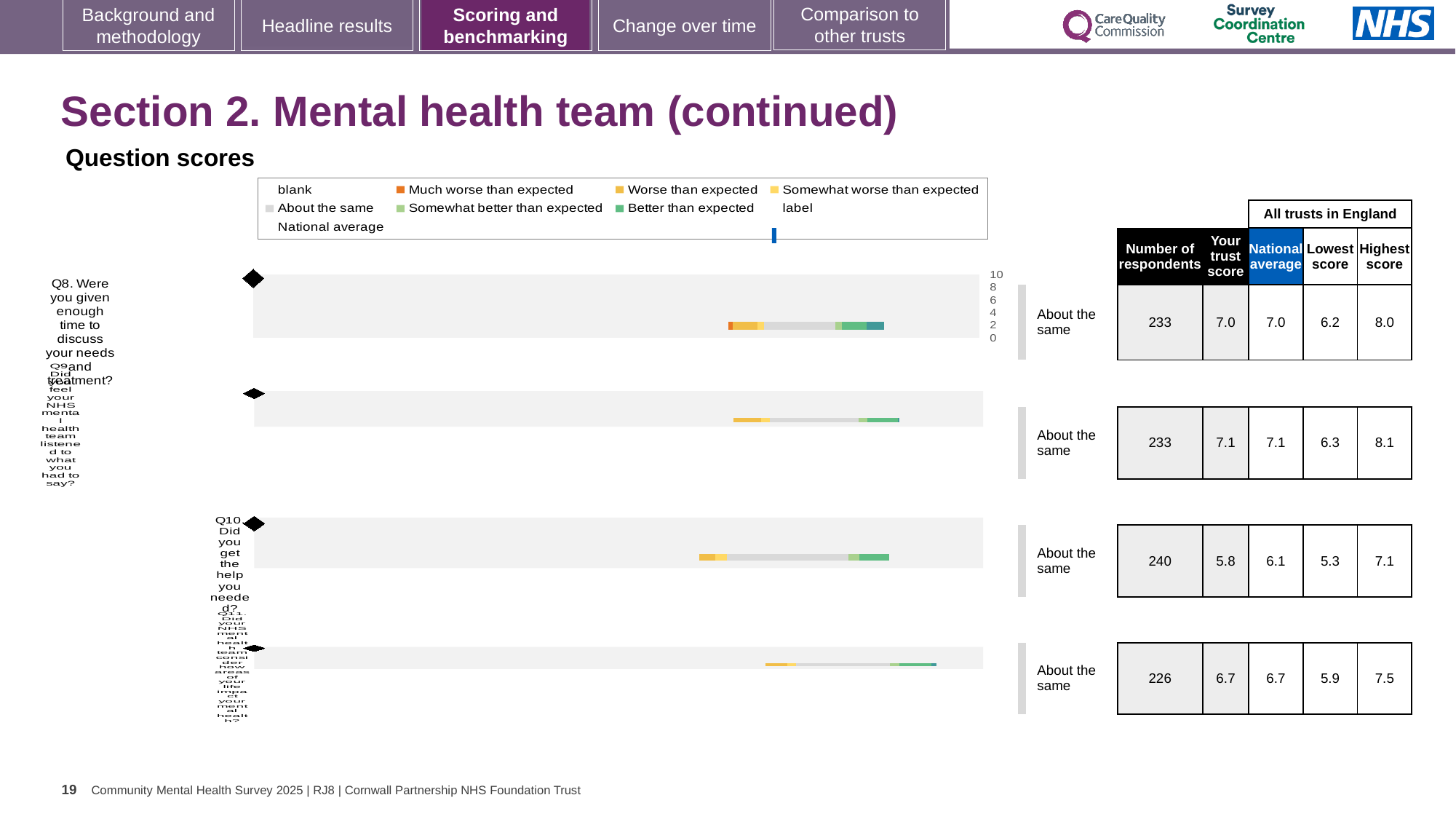
Which question has the lowest 'Your trust score' on this slide? Q10 How many questions are charted on this slide? 4 Which question has the highest number of respondents on this slide? Q10 For Q10, which is larger: the trust score or the national average? National average What is the difference between the highest score and the lowest score for Q8? 1.8 What benchmark category is shown next to the Q8 chart? About the same What is the national average score for Q11 (Did your NHS mental health team consider how areas of your life impact your mental health?)? 6.7 How many respondents are shown for Q8 (Were you given enough time to discuss your needs and treatment?)? 233 What is the highest score among all trusts in England for Q9 (Did you feel your NHS mental health team listened to what you had to say?)? 8.1 What is the lowest score among all trusts in England for Q11? 5.9 What kind of chart is used to show the question scores on this slide? Bar chart What is the 'Your trust score' value for Q10 (Did you get the help you needed?)? 5.8